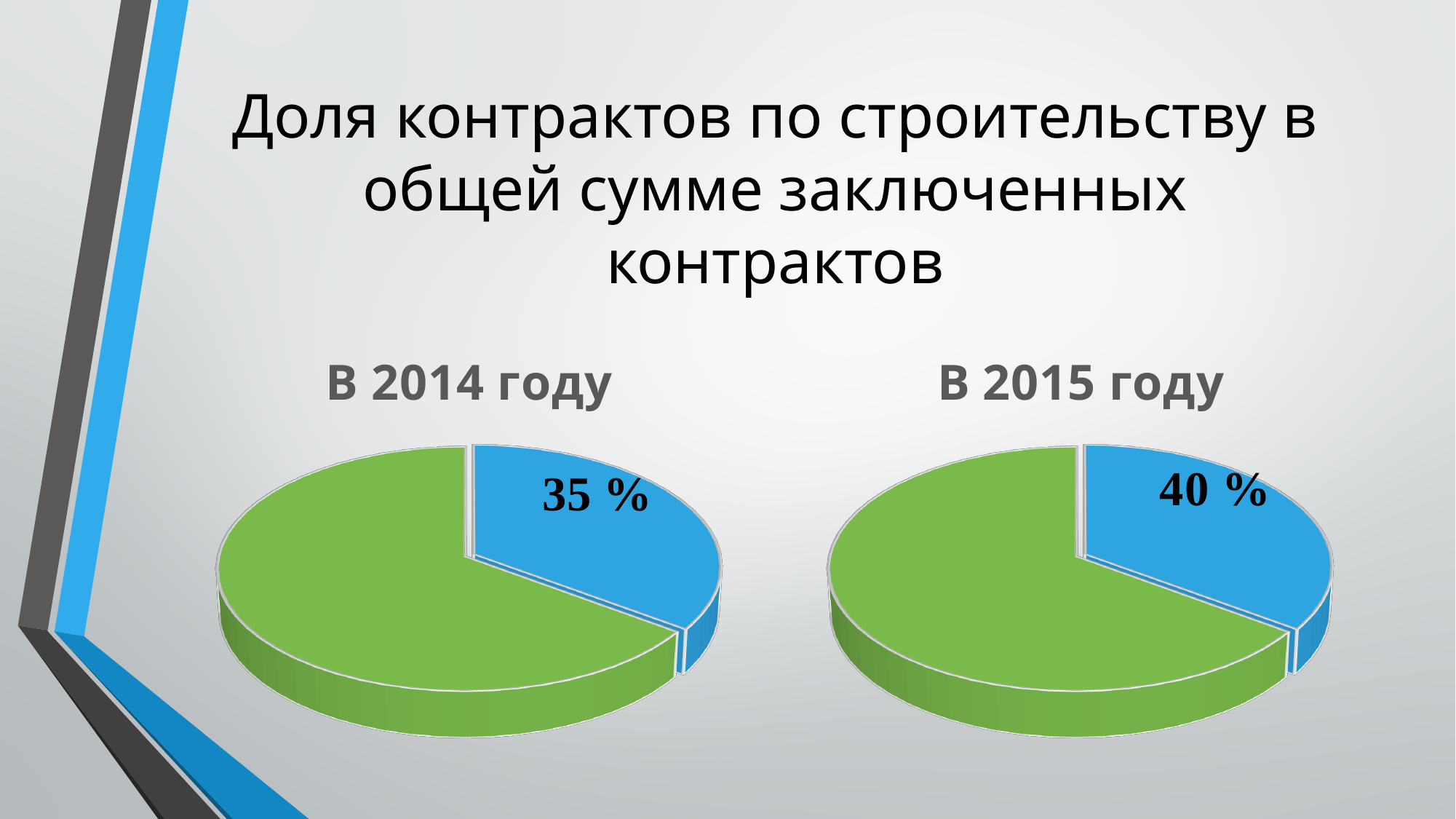
Does the labelled blue share rise or fall from the "В 2014 году" chart to the "В 2015 году" chart? rise What is the difference between the blue slice value in the "В 2015 году" chart and the blue slice value in the "В 2014 году" chart? 5 % How many pie charts are shown on the slide? 2 What colour is the slice that carries the "40 %" label in the chart titled "В 2015 году"? blue Which chart has the larger labelled blue slice, "В 2014 году" or "В 2015 году"? В 2015 году In the chart titled "В 2014 году", which slice is larger, the green one or the blue one? green What is the title of the left pie chart? В 2014 году In the chart titled "В 2014 году", what value is printed on the blue slice? 35 % In the chart titled "В 2015 году", is the blue slice larger or smaller than the green slice? smaller What kind of chart is the chart titled "В 2014 году"? pie chart In the chart titled "В 2015 году", what value is printed on the blue slice? 40 % How many slices does the chart titled "В 2014 году" have? 2